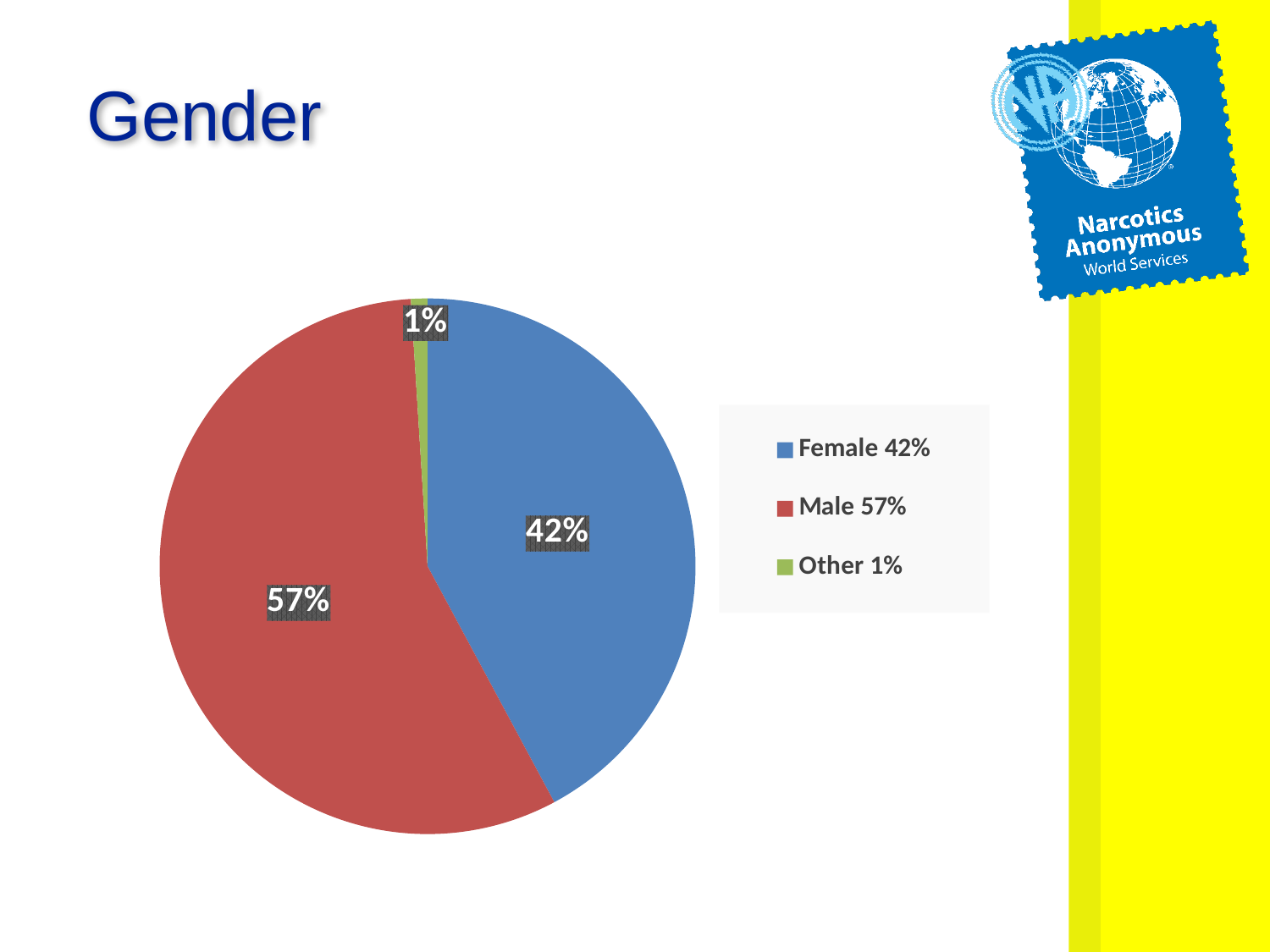
What is the difference in percentage points between Female and Other? 41 Which category has the largest share of the pie? Male What is the title of the slide containing the pie chart? Gender What is the difference in percentage points between Male and Female? 15 What percentage of the pie is Other? 1% What kind of chart is shown on the slide? pie chart Which category has the smallest share of the pie? Other What percentage of the pie is Female? 42% What colour is the Male slice of the pie? red How many categories does the pie chart show? 3 What percentage of the pie is Male? 57% Which is larger, the Female share or the Male share? Male